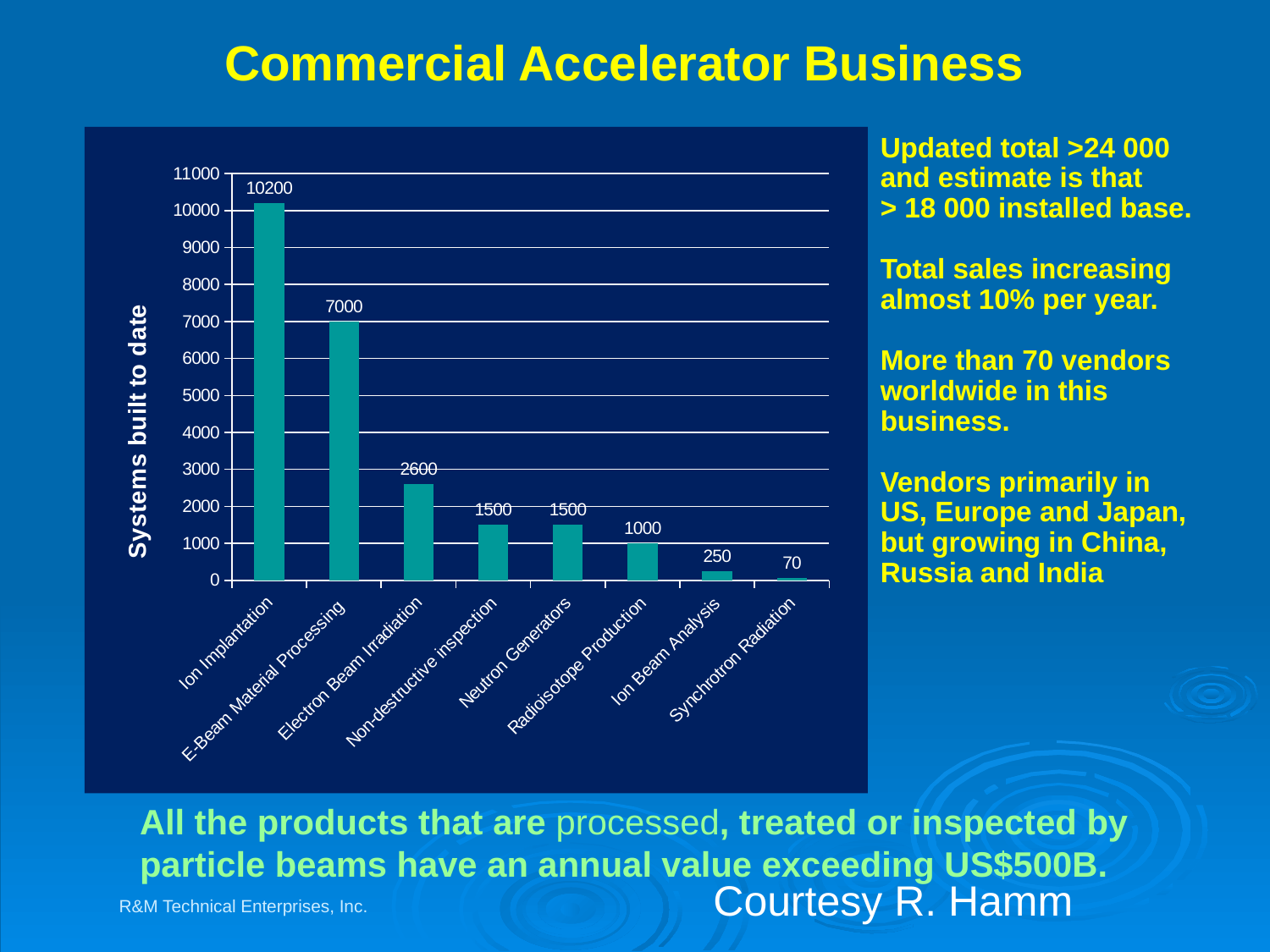
What is the value for E-Beam Material Processing? 7000 What is the label of the vertical axis of the chart? Systems built to date Which category has the highest number of systems built to date? Ion Implantation Which category has the lowest number of systems built to date? Synchrotron Radiation What is the value for Radioisotope Production? 1000 What kind of chart is shown on the slide? Bar chart What is the value for Synchrotron Radiation? 70 How many categories are shown on the x axis of the chart? 8 What is the difference between the values for Ion Implantation and E-Beam Material Processing? 3200 How many systems built to date are shown for Ion Implantation? 10200 What is the difference between the values for Electron Beam Irradiation and Ion Beam Analysis? 2350 Which is larger, the value for Electron Beam Irradiation or the value for Neutron Generators? Electron Beam Irradiation